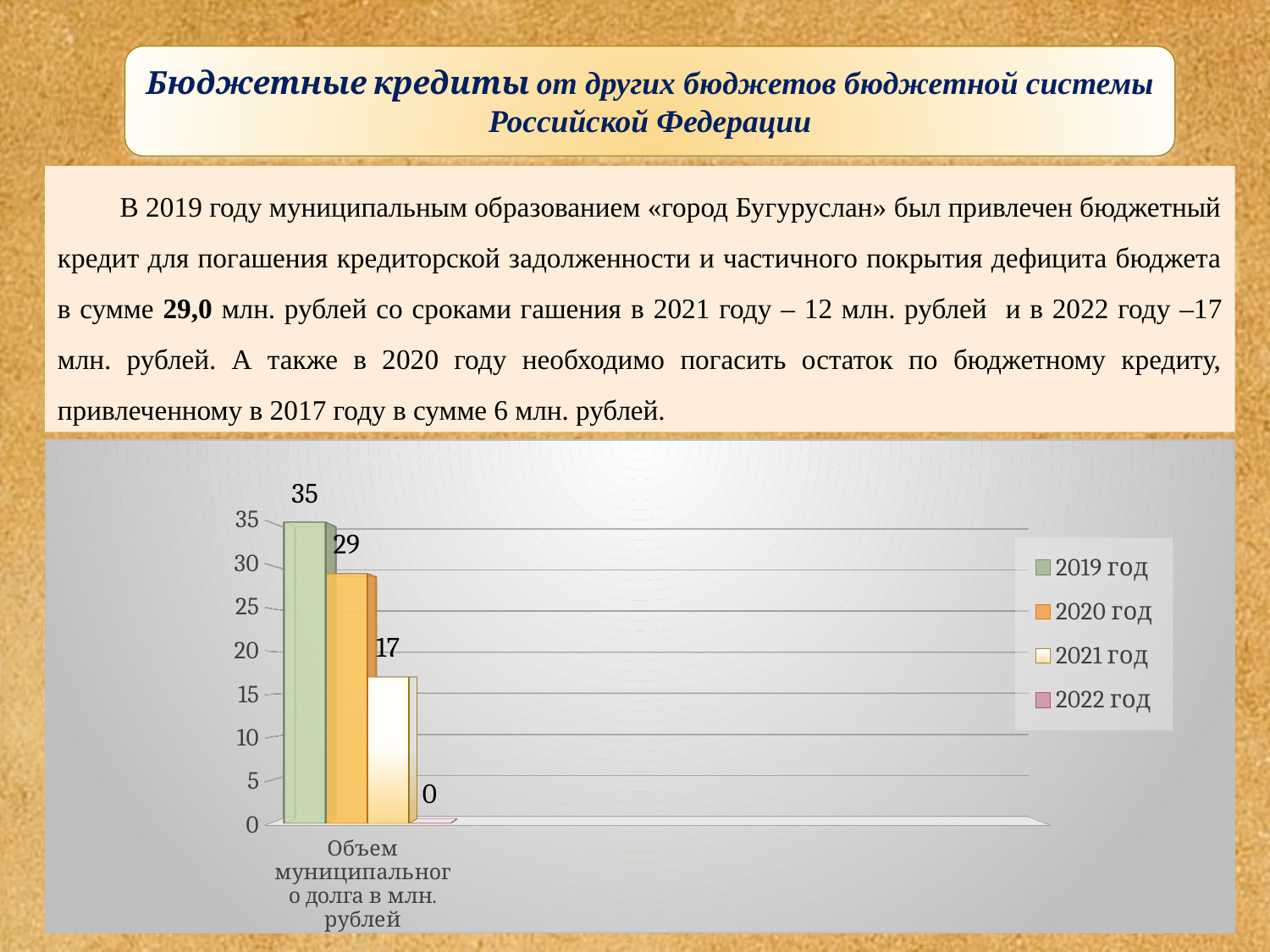
Which is larger, the value for 2020 год or the value for 2021 год? 2020 год What is the value for the 2022 год series in the chart? 0 What is the value for the 2019 год series in the chart? 35 What is the value for the 2021 год series in the chart? 17 Which series has the lowest value in the chart? 2022 год What is the value for the 2020 год series in the chart? 29 What is the difference between the values for 2020 год and 2021 год? 12 How many series does the legend list? 4 What is the category label shown on the x axis of the chart? Объем муниципального долга в млн. рублей What is the difference between the values for 2019 год and 2020 год? 6 What kind of chart is shown on the slide? Bar chart Which series has the highest value in the chart? 2019 год